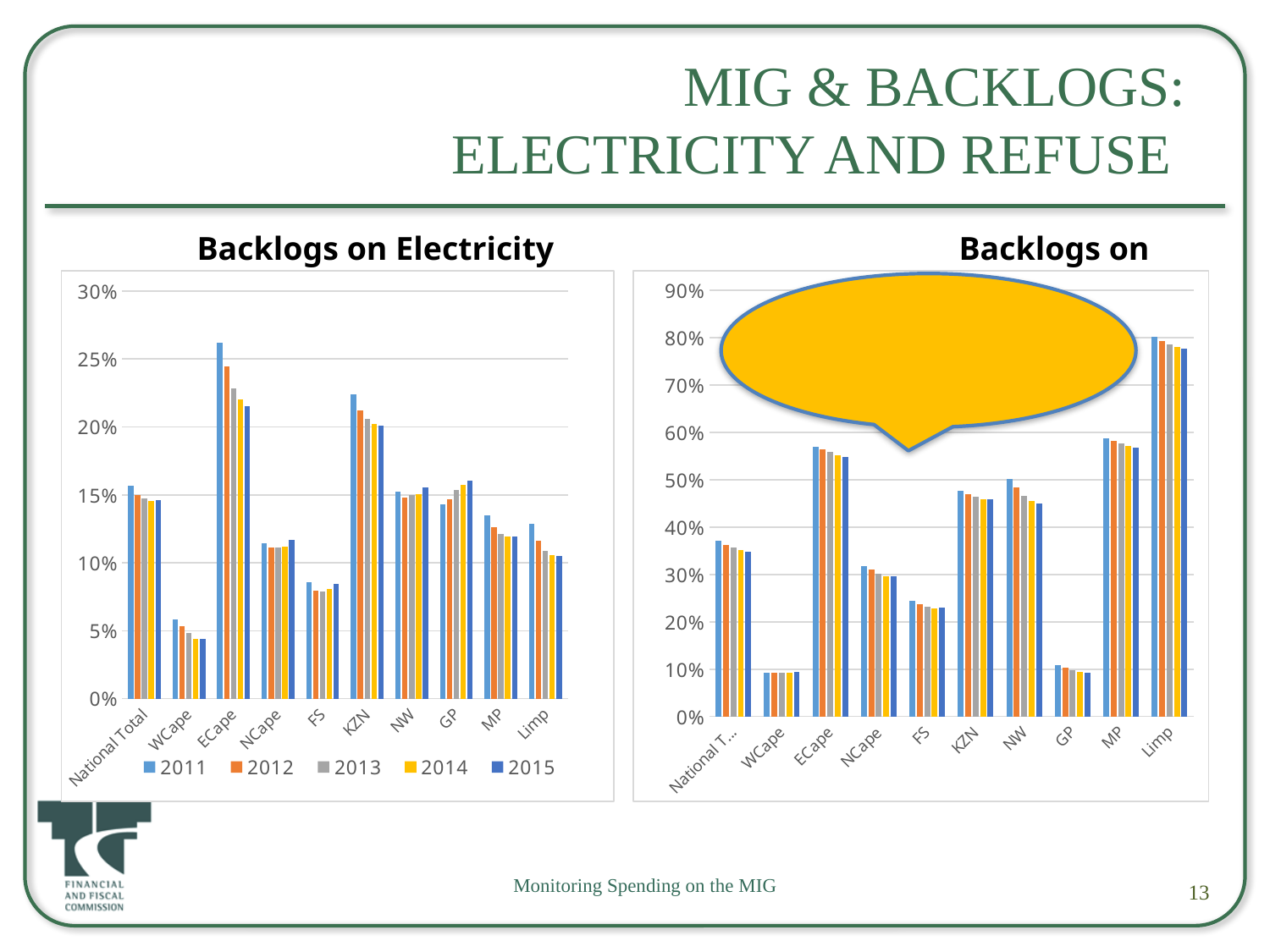
How many series does the legend of the "Backlogs on Electricity" chart list? 5 In the "Backlogs on Electricity" chart, which category has the highest 2011 value? ECape In the "Backlogs on Electricity" chart, is the 2011 value for WCape greater or less than 10%? less In the "Backlogs on Electricity" chart, which is larger for 2011: ECape or KZN? ECape How many categories are shown on the x axis of the "Backlogs on Electricity" chart? 10 In the "Backlogs on Electricity" chart, which category has the lowest 2011 value? WCape In the right-hand chart, is the first bar for WCape greater or less than 20%? less In the right-hand chart, which category has the highest values? Limp What kind of chart is the "Backlogs on Electricity" chart? Bar chart In the "Backlogs on Electricity" chart, do the values for ECape rise or fall from 2011 to 2015? fall In the "Backlogs on Electricity" chart, is the 2011 value for ECape greater or less than 25%? greater